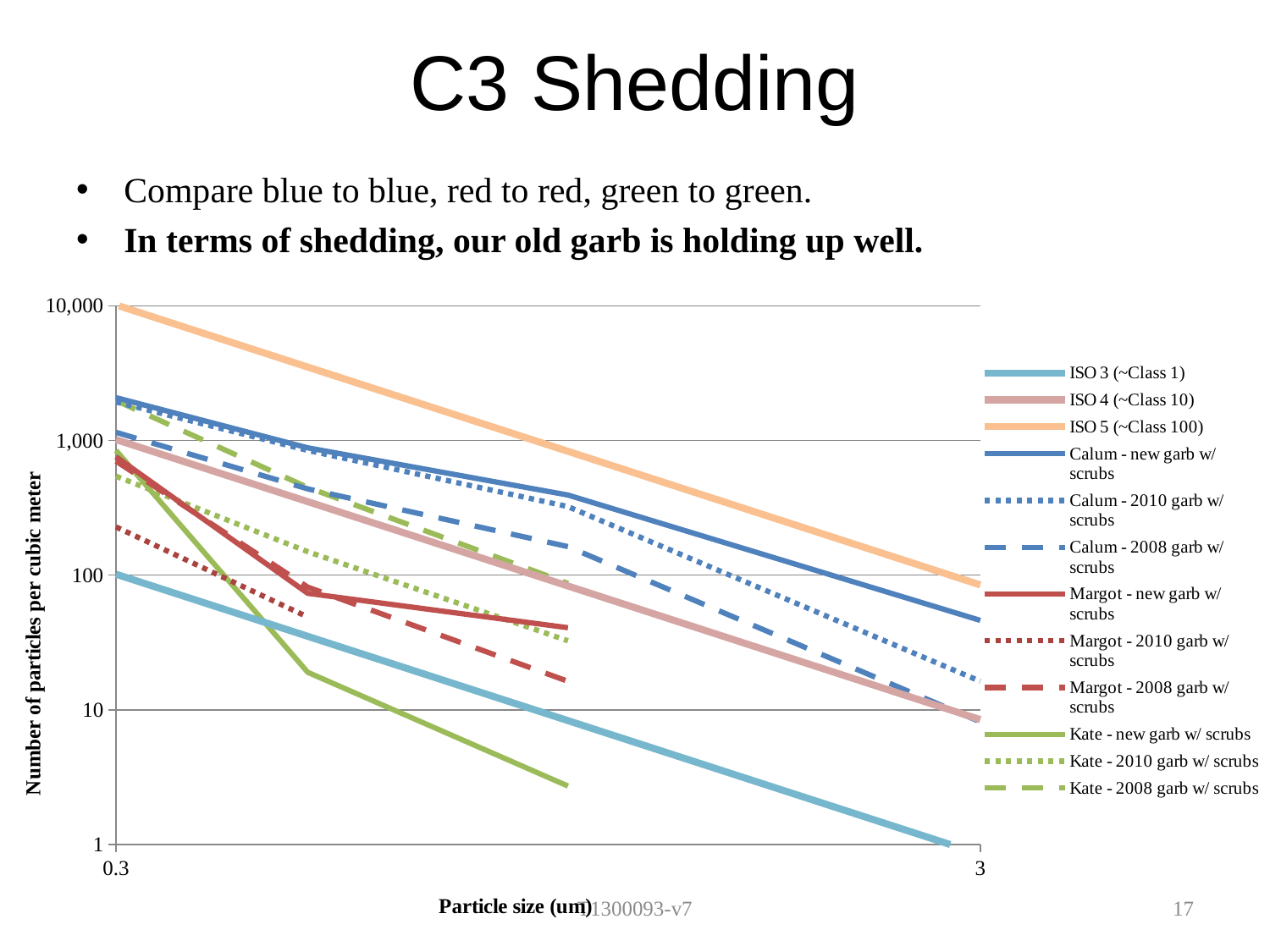
What kind of chart is shown on the slide? line chart How many series does the chart legend list? 12 Is the value at the right-hand end of the Kate - new garb w/ scrubs line greater or less than 10? less Is the value for Margot - 2010 garb w/ scrubs at particle size 0.3 greater or less than 1,000? less What is the title of the chart's y axis? Number of particles per cubic meter Which series has the highest values across the chart? ISO 5 (~Class 100) Do the lines rise or fall as particle size increases along the x axis? fall At particle size 0.3, which is higher: Calum - new garb w/ scrubs or Kate - new garb w/ scrubs? Calum - new garb w/ scrubs What is the title of the chart's x axis? Particle size (um)